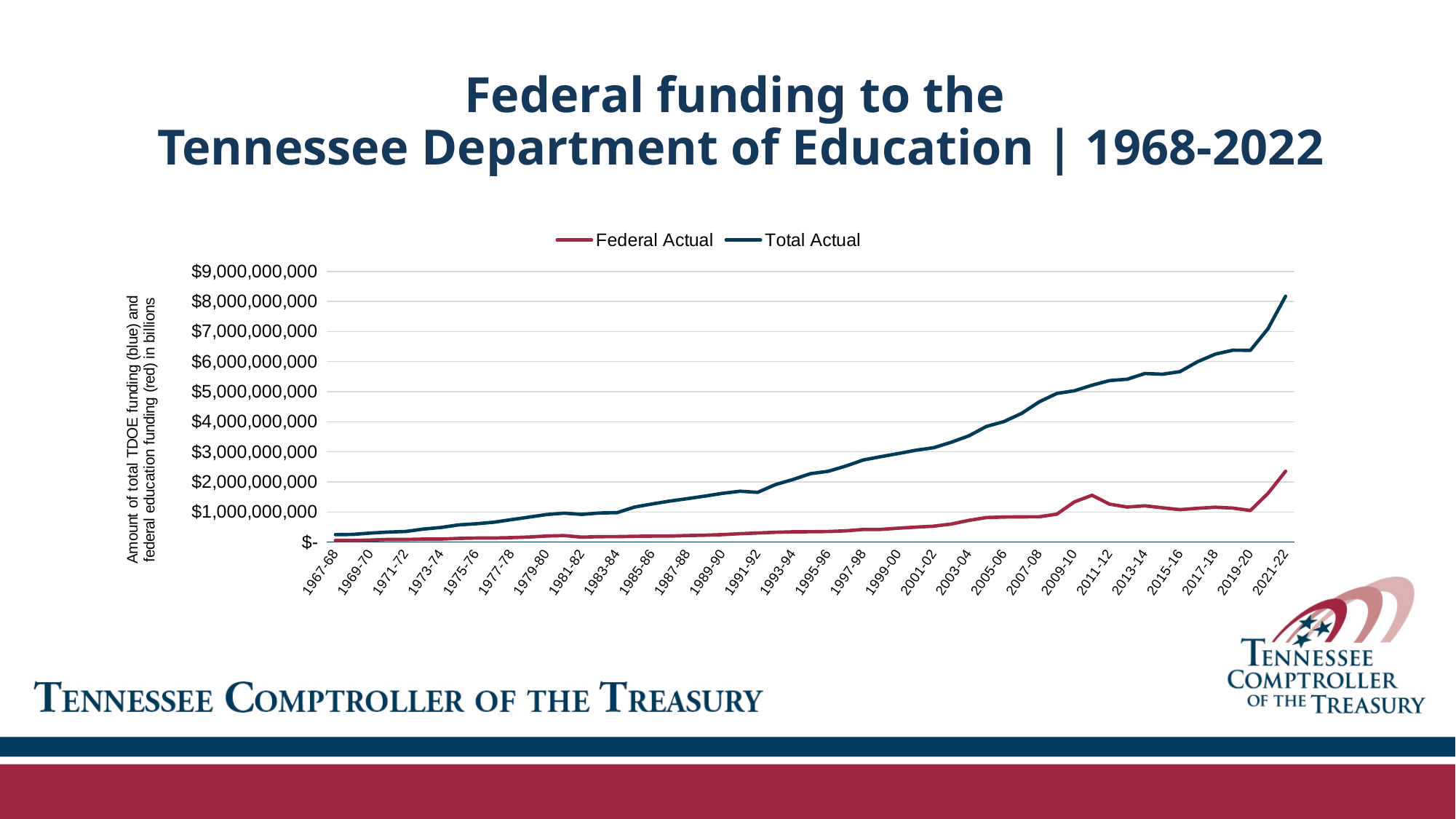
What are the two series named in the legend? Federal Actual and Total Actual Does the Total Actual line generally rise or fall from 1967-68 to 2021-22? Rise In which year label does the Total Actual series reach its highest value? 2021-22 Is the value for Total Actual in 1991-92 greater or less than $2,000,000,000? less Is the value for Total Actual in 2021-22 greater or less than $7,000,000,000? greater Is the value for Federal Actual in 2021-22 greater or less than $2,000,000,000? greater What kind of chart is shown on the slide? Line chart Which series is drawn in red? Federal Actual How many series does the legend list? 2 Which series has the larger value in 2021-22, Federal Actual or Total Actual? Total Actual